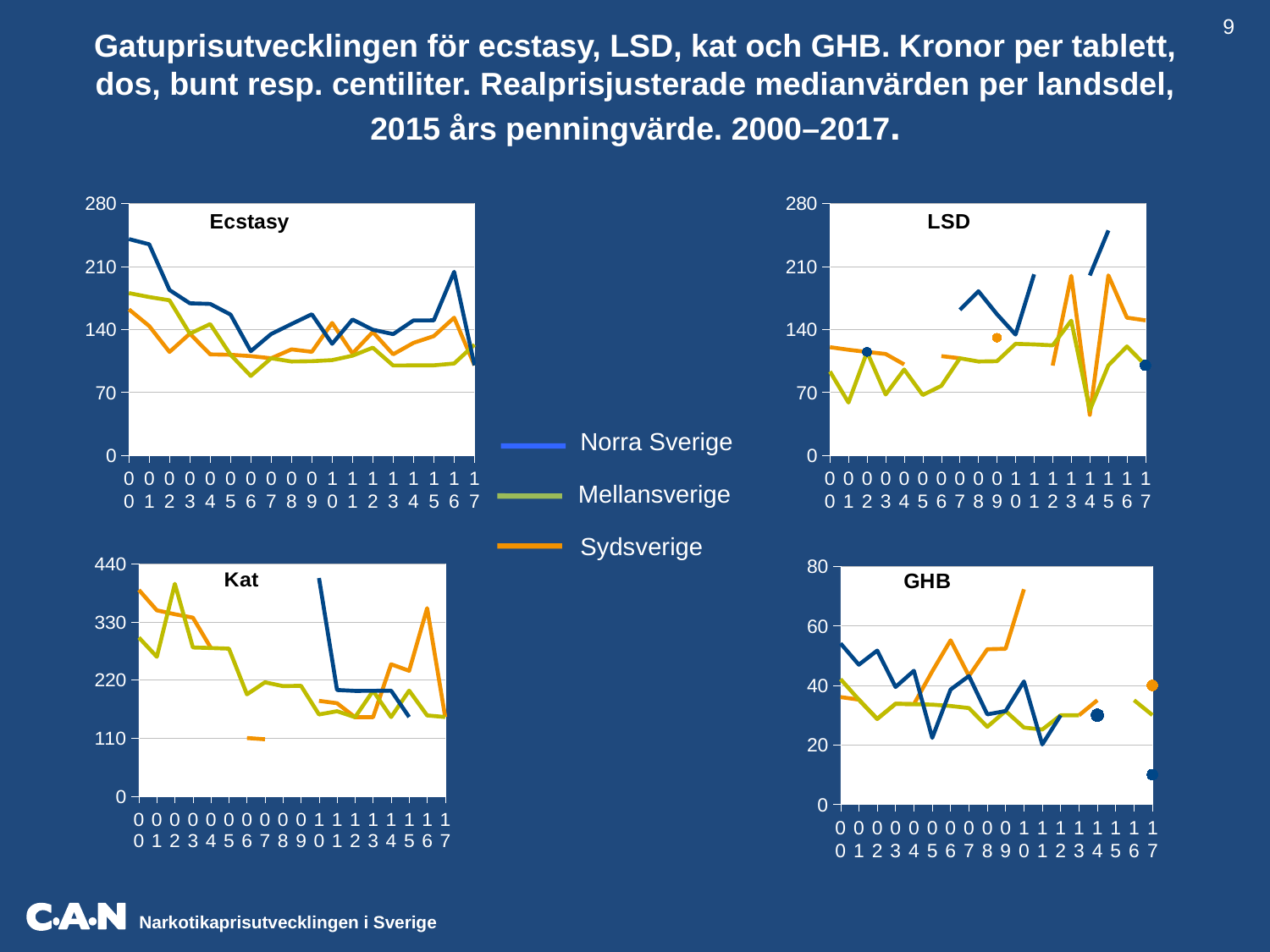
In the Ecstasy chart, is the value for Norra Sverige in year 00 greater or less than 210? greater In the Kat chart, does the Mellansverige line overall rise or fall from year 00 to year 17? fall How many years are shown on the x axis of the GHB chart? 18 What kind of chart is the Ecstasy chart? line chart In the LSD chart, is the value for Mellansverige in year 01 greater or less than 70? less In the Ecstasy chart, which series has the higher value in year 00, Norra Sverige or Mellansverige? Norra Sverige In the Kat chart, is the value for Norra Sverige in year 10 greater or less than 330? greater Which series is shown in orange in the legend? Sydsverige How many series does the legend list? 3 What is the title of the chart in the bottom-left position of the slide? Kat